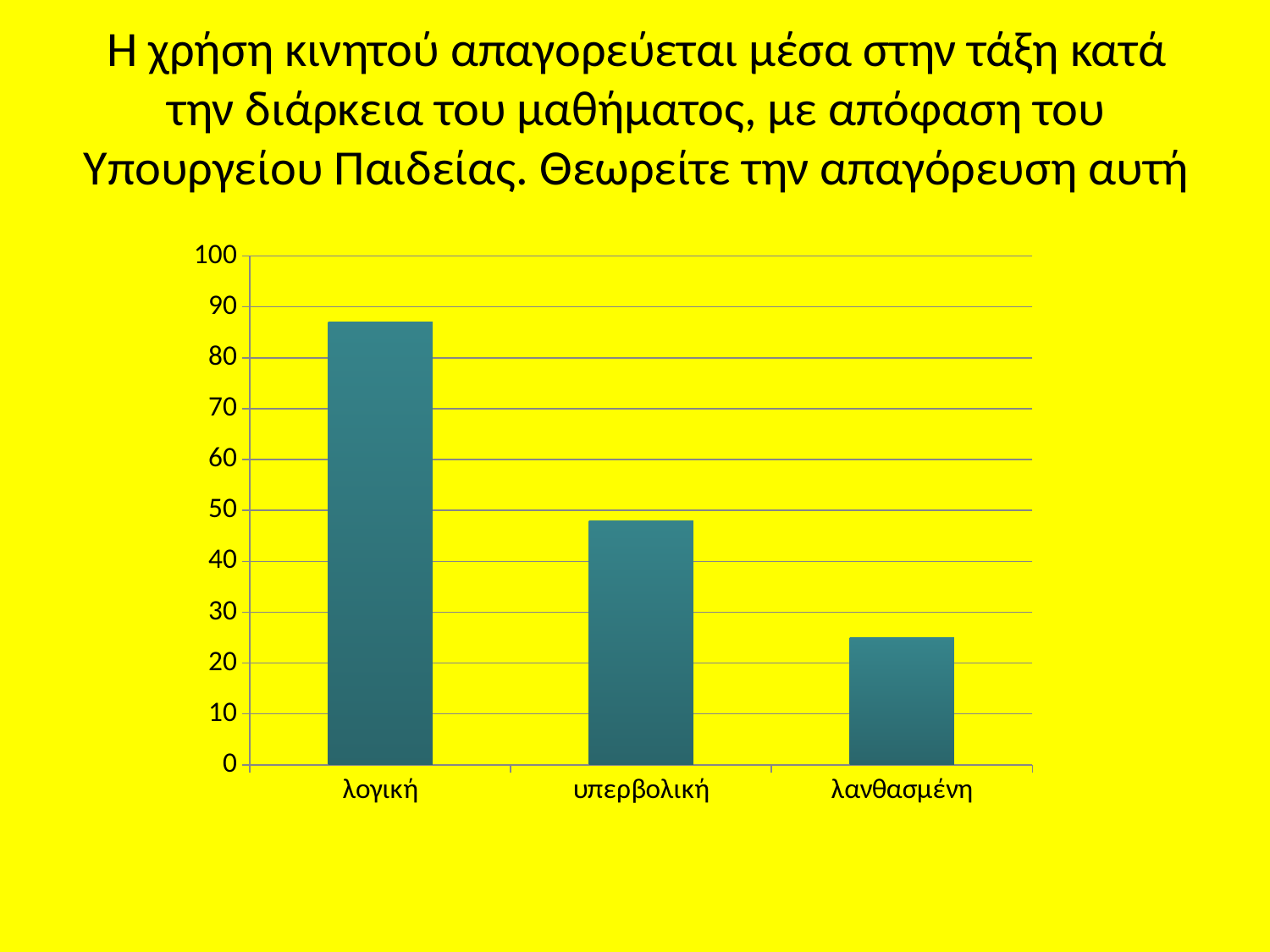
Which category has the lowest bar in the chart? λανθασμένη Is the value for λογική greater or less than 80? greater Which category has the highest bar in the chart? λογική What is the maximum value shown on the vertical axis of the chart? 100 How many categories are shown on the x axis of the chart? 3 Which is larger, the value for λογική or the value for υπερβολική? λογική What kind of chart is shown on the slide? bar chart Is the value for λογική greater or less than 90? less Which is larger, the value for υπερβολική or the value for λανθασμένη? υπερβολική Is the value for λανθασμένη greater or less than 30? less Do the bar values rise or fall from left to right along the x axis? fall